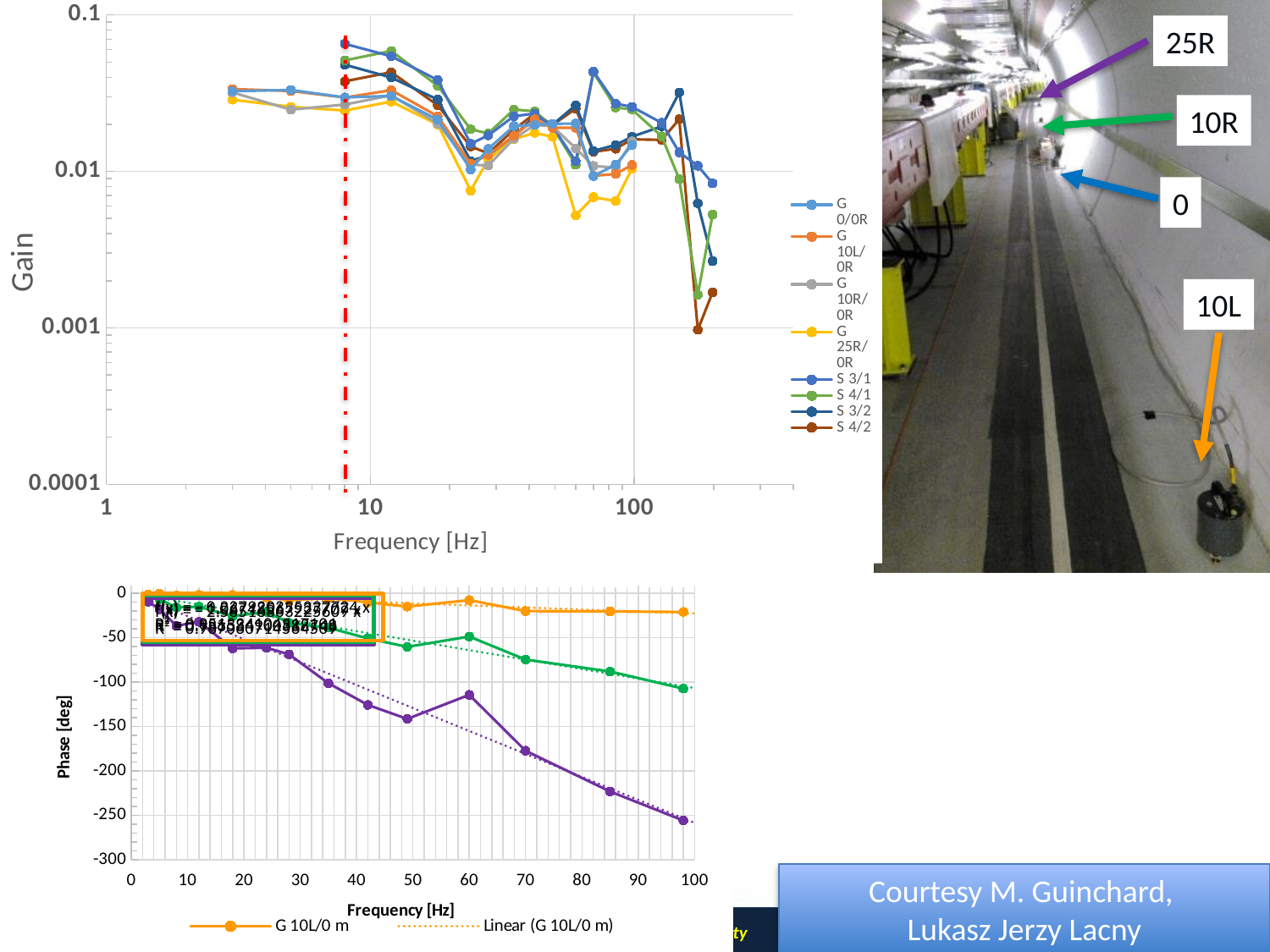
On the top-left Gain chart, is any plotted gain value greater or less than 0.1? less What kind of chart is the top-left chart of Gain versus Frequency? line chart On the bottom-left Phase chart, is the phase of the orange G 10L/0 m series at about 100 Hz greater or less than -50? greater On the top-left Gain chart, do the gain values rise or fall as frequency increases beyond 100 Hz? fall How many series does the legend of the top-left Gain chart list? 8 On the top-left Gain chart, is the gain for G 25R/0R at about 60 Hz greater or less than 0.01? less What is the label of the x axis on the top-left Gain chart? Frequency [Hz] What is the label of the y axis on the top-left chart? Gain On the bottom-left Phase chart, which series has the lowest phase at about 100 Hz: the orange, green or purple series? purple On the bottom-left Phase chart, does the phase of the purple series rise or fall as frequency increases? fall What kind of chart is the bottom-left chart of Phase versus Frequency? line chart